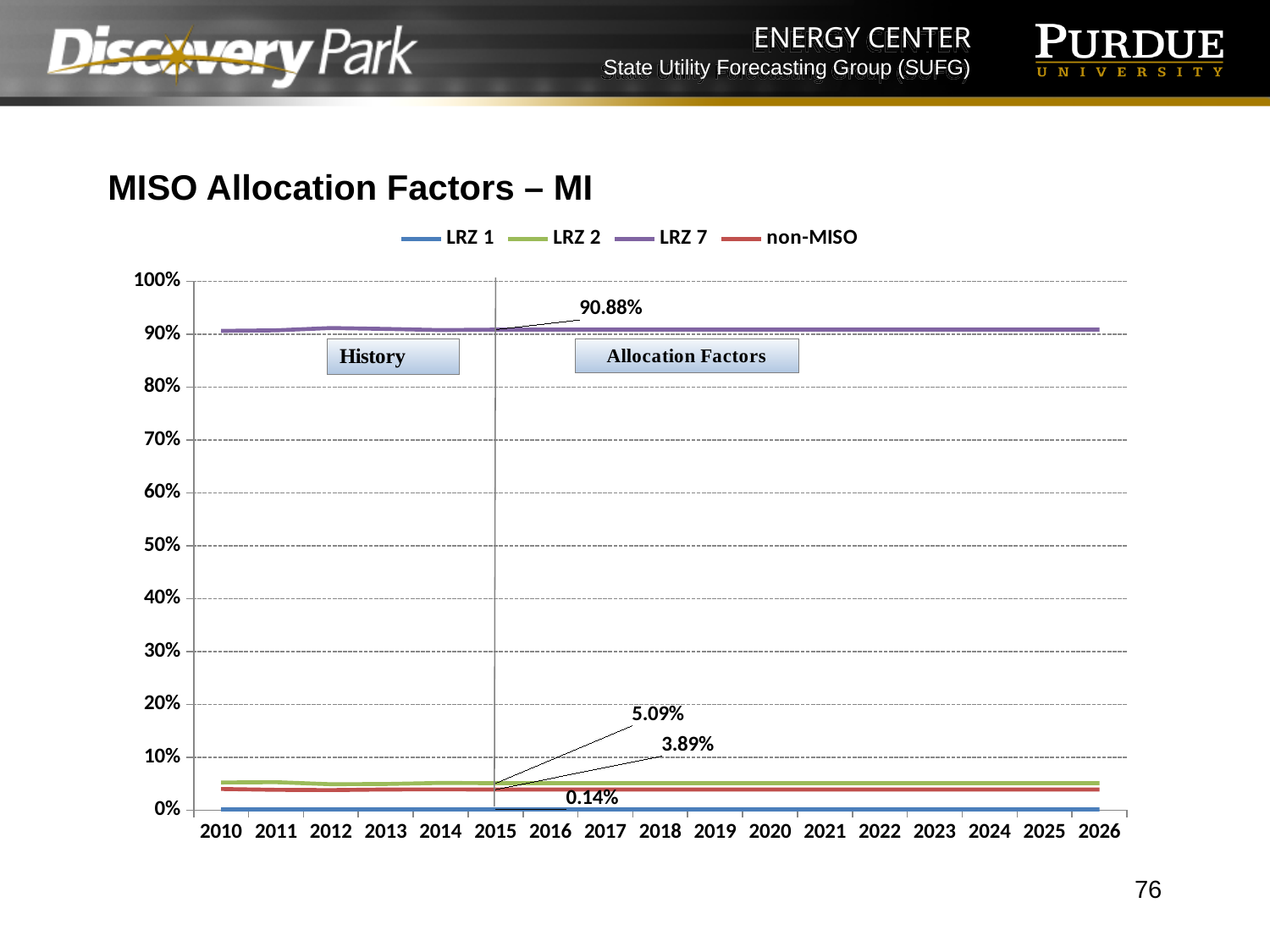
Which series has the lowest values throughout the chart? LRZ 1 What value is labelled for the non-MISO line? 3.89% Is the value for LRZ 7 in 2010 greater or less than 80%? greater What value is labelled for the LRZ 2 line? 5.09% What value is labelled for the LRZ 7 line? 90.88% Which series has the highest values throughout the chart? LRZ 7 What is the title of the chart? MISO Allocation Factors – MI What is the difference between the labelled LRZ 2 value and the labelled non-MISO value? 1.20% What kind of chart is shown on the slide? line chart How many years are shown along the x axis? 17 How many series does the legend list? 4 What value is labelled for the LRZ 1 line? 0.14%